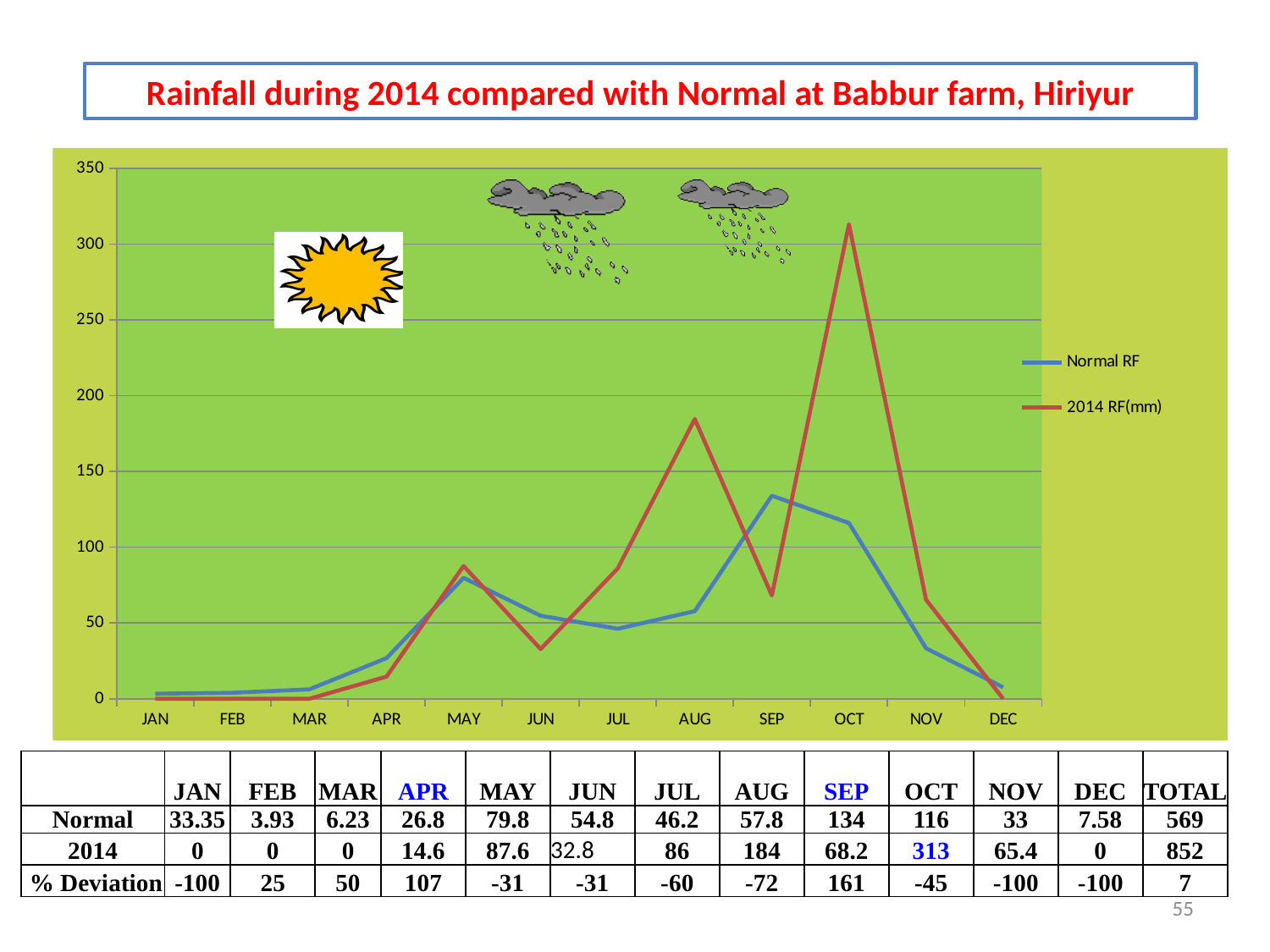
How many months are plotted along the x axis of the chart? 12 Is the 2014 RF(mm) value for MAY greater or less than 100? less What kind of chart is shown on the slide? line chart Does the Normal RF series rise or fall from SEP to DEC? fall What is the 2014 RF(mm) value for AUG? 184 How many series does the chart legend list? 2 In SEP, which is larger: Normal RF or 2014 RF(mm)? Normal RF In which month does the Normal RF series reach its highest value? SEP What is the Normal RF value for SEP? 134 Is the 2014 RF(mm) value for OCT greater or less than 300? greater In which month does the 2014 RF(mm) series reach its highest value? OCT By how much does the 2014 RF(mm) value in OCT exceed the Normal RF value in OCT? 197